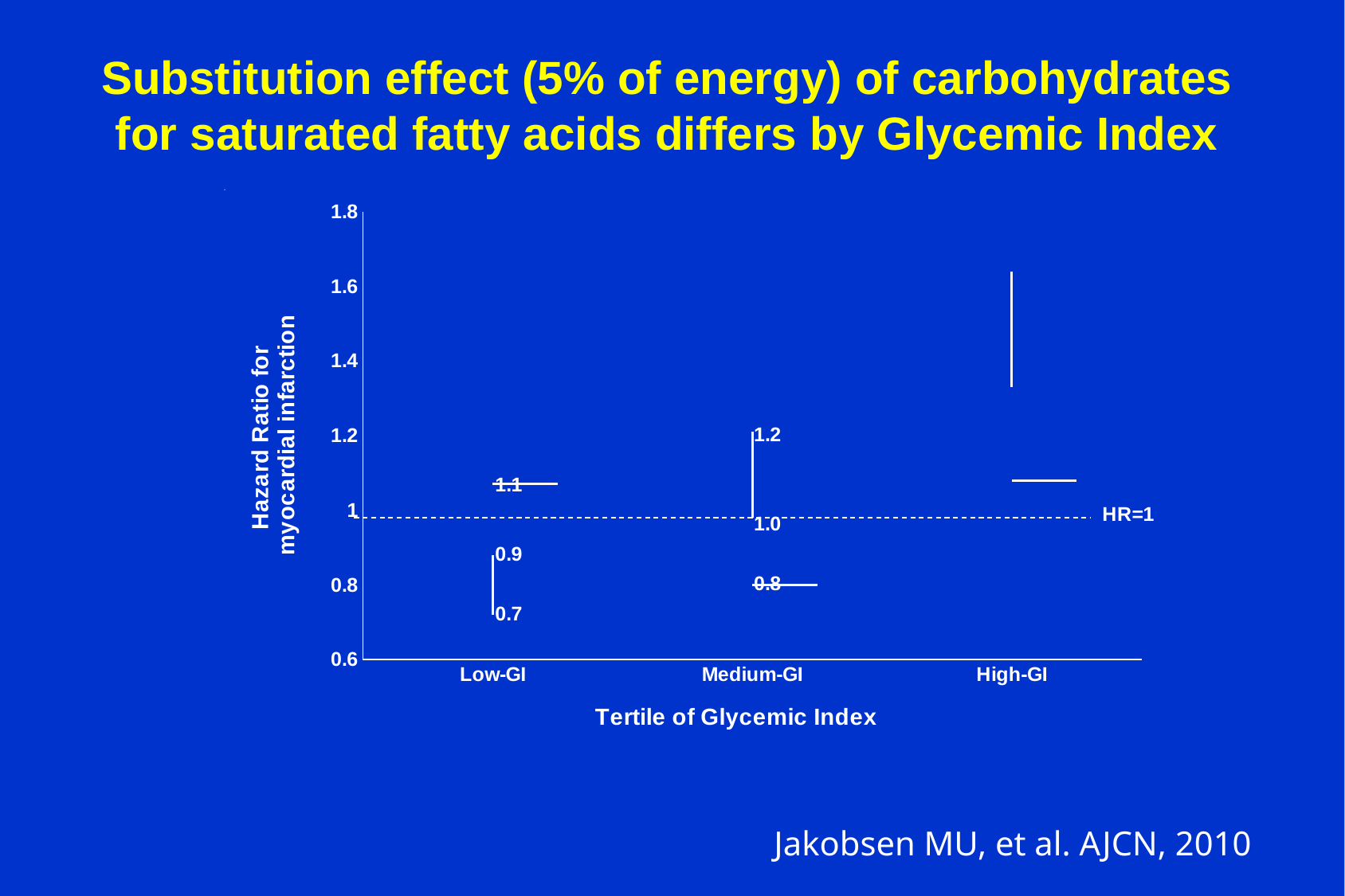
What is the minimum value shown on the y axis? 0.6 What is the lowest data label printed for the Low-GI tertile? 0.7 Is the top of the vertical bar for High-GI greater or less than 1.4? greater How many tertile categories are shown on the x axis? 3 Which tertile has a vertical bar that extends highest on the y axis? High-GI What label is attached to the dashed horizontal reference line? HR=1 What is the highest data label printed for the Low-GI tertile? 1.1 What is the highest data label printed for the Medium-GI tertile? 1.2 What is the maximum value shown on the y axis? 1.8 What is the title of the chart's x axis? Tertile of Glycemic Index What is the title of the chart's y axis? Hazard Ratio for myocardial infarction What is the lowest data label printed for the Medium-GI tertile? 0.8